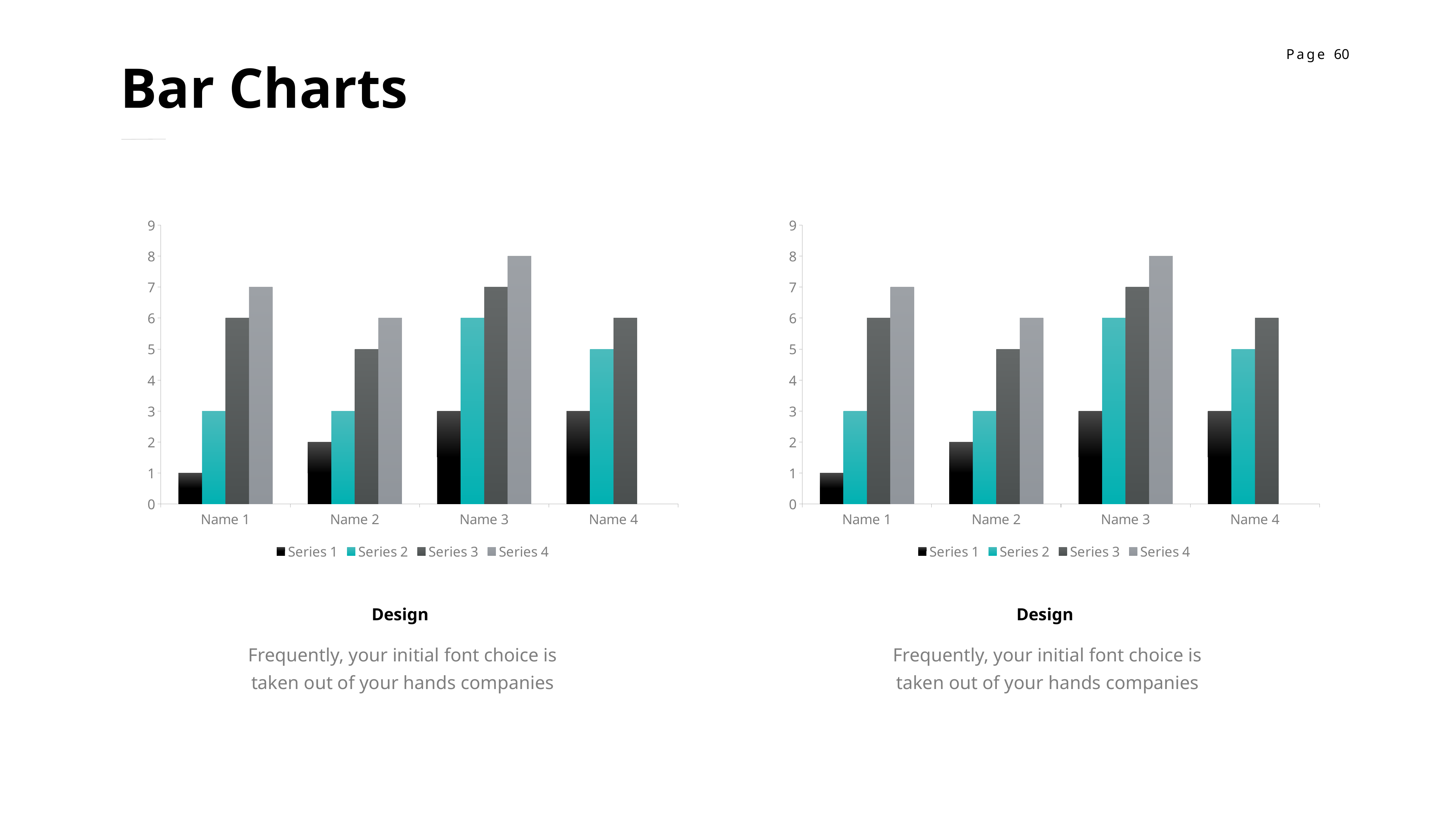
How many series does the legend of the right chart list? 4 How many categories are shown on the x axis of the left chart? 4 On the left chart, what is the difference between the Series 4 value for Name 3 and the Series 4 value for Name 2? 2 What kind of chart is the left chart? Bar chart On the left chart, what is the value of Series 4 for Name 3? 8 On the right chart, which is larger: Series 2 for Name 3 or Series 2 for Name 4? Series 2 for Name 3 On the right chart, what is the value of Series 3 for Name 2? 5 On the right chart, which series is shown in teal? Series 2 On the left chart, which category has the highest Series 1 value? Name 3 and Name 4 (both 3) On the right chart, which category has the lowest Series 1 value? Name 1 On the right chart, what is the value of Series 2 for Name 4? 5 On the left chart, what is the value of Series 1 for Name 1? 1